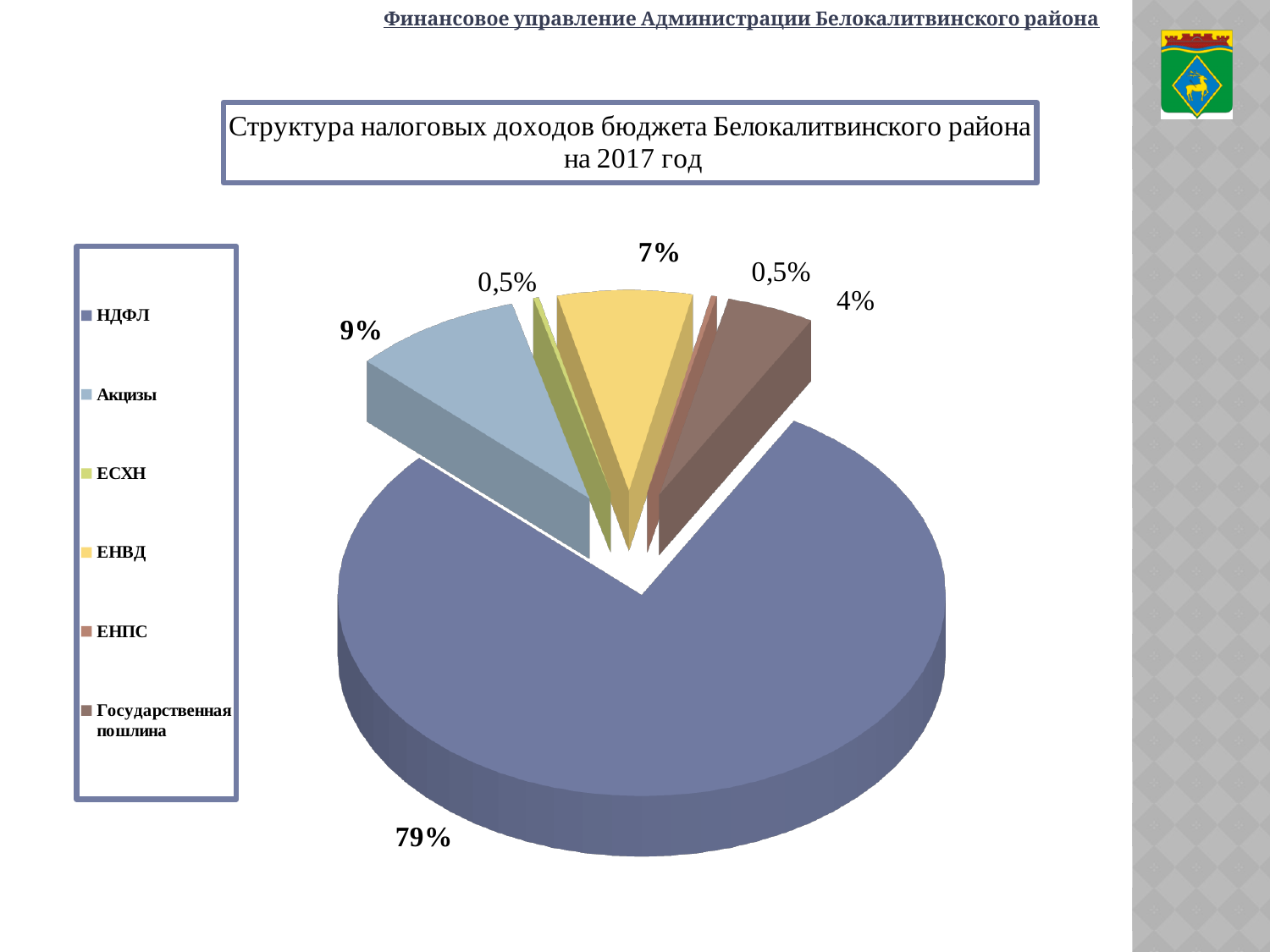
What is the title of the chart? Структура налоговых доходов бюджета Белокалитвинского района на 2017 год What is the value shown for Государственная пошлина? 4% What kind of chart is shown on the slide? Pie chart What share of the pie does НДФЛ hold? 79% How many categories does the legend list? 6 What is the value shown for ЕСХН? 0,5% Which is larger, the share of ЕНВД or the share of Государственная пошлина? ЕНВД What is the difference between the shares of НДФЛ and Акцизы? 70% Which category has the largest slice of the pie? НДФЛ What is the value shown for Акцизы? 9% What is the difference between the shares of Акцизы and ЕНВД? 2% What is the value shown for ЕНВД? 7%